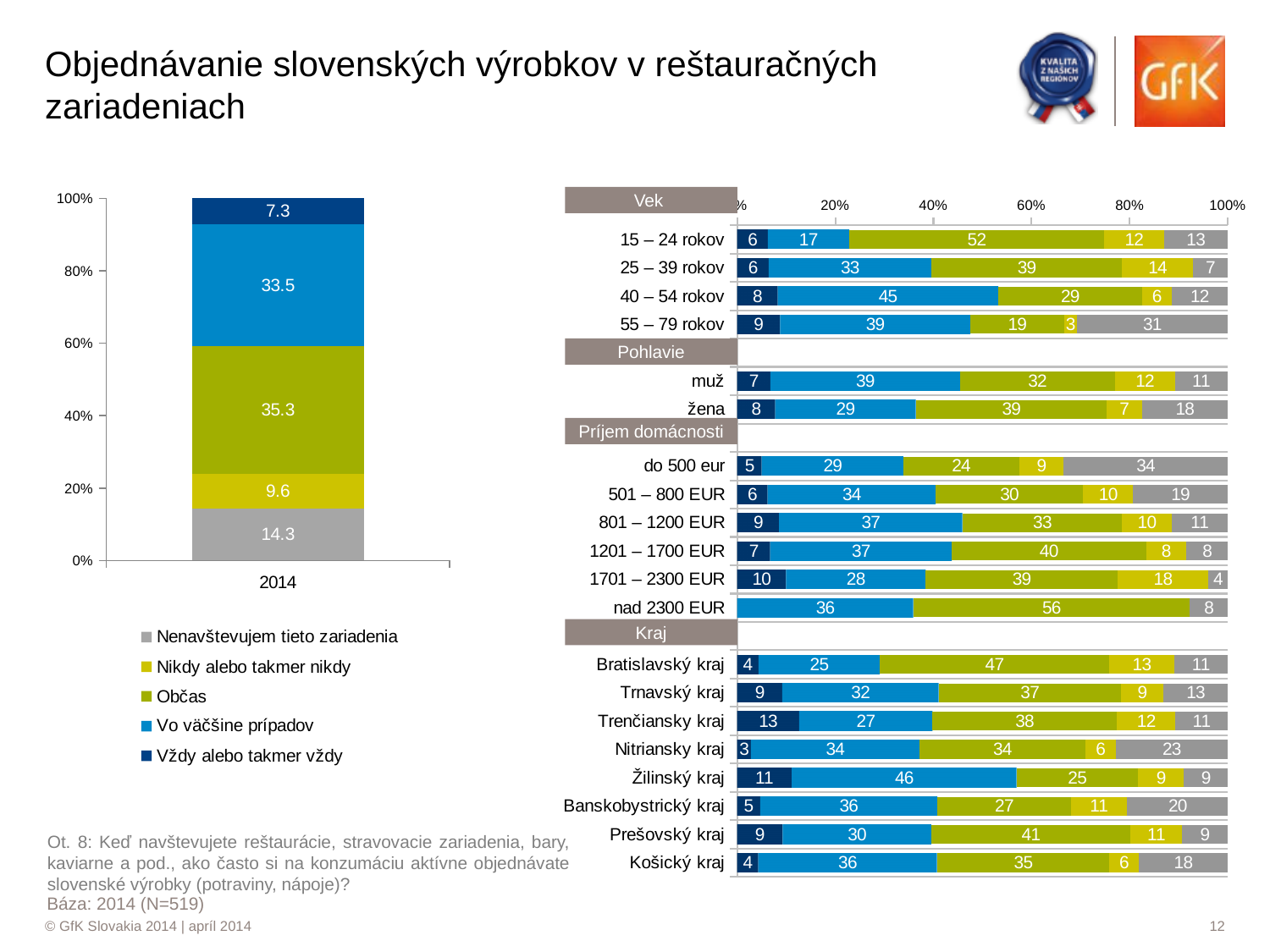
In the left stacked bar chart, which segment has the smallest value? Vždy alebo takmer vždy In the left stacked bar chart, what is the value of the 'Občas' segment for 2014? 35.3 In the right chart, which age group has the largest green 'Občas' segment? 15 – 24 rokov In the right chart, what is the value of the grey 'Nenavštevujem tieto zariadenia' segment for 'do 500 eur'? 34 In the right chart, what is the value of the green 'Občas' segment for '15 – 24 rokov'? 52 What type of chart is the chart on the left of the slide? Stacked bar chart In the right chart, what is the value of the light blue 'Vo väčšine prípadov' segment for 'Žilinský kraj'? 46 How many series does the legend of the left stacked bar chart list? 5 In the left stacked bar chart, what is the difference between the 'Vo väčšine prípadov' and 'Nenavštevujem tieto zariadenia' values? 19.2 In the right chart, how many regions (kraj) are listed? 8 In the left stacked bar chart, what is the value of the 'Vždy alebo takmer vždy' segment for 2014? 7.3 In the right chart, is the green 'Občas' segment larger for 'muž' or for 'žena'? žena